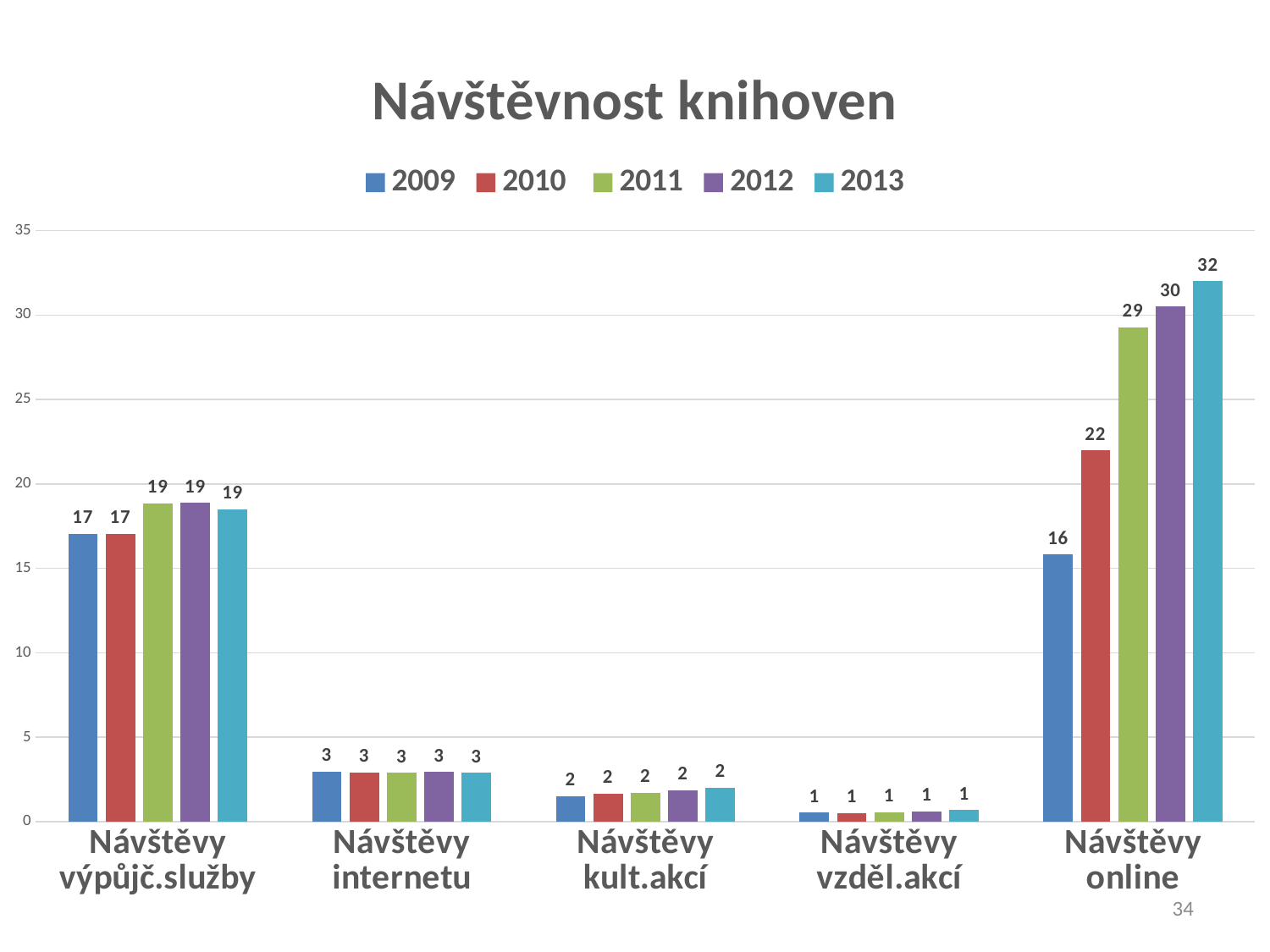
What is the value for 2009 in the Návštěvy výpůjč.služby category? 17 Which category has the lowest value for 2011? Návštěvy vzděl.akcí How many categories are shown on the x axis? 5 Which is larger in the Návštěvy výpůjč.služby category: the value for 2010 or the value for 2012? 2012 Do the values for Návštěvy online rise or fall from 2009 to 2013? rise How many series does the legend list? 5 What is the value for 2010 in the Návštěvy online category? 22 What is the title of the chart? Návštěvnost knihoven Which category has the highest value for 2013? Návštěvy online What is the value for 2013 in the Návštěvy online category? 32 What is the difference between the 2013 and 2009 values in the Návštěvy online category? 16 What kind of chart is shown on the slide? bar chart